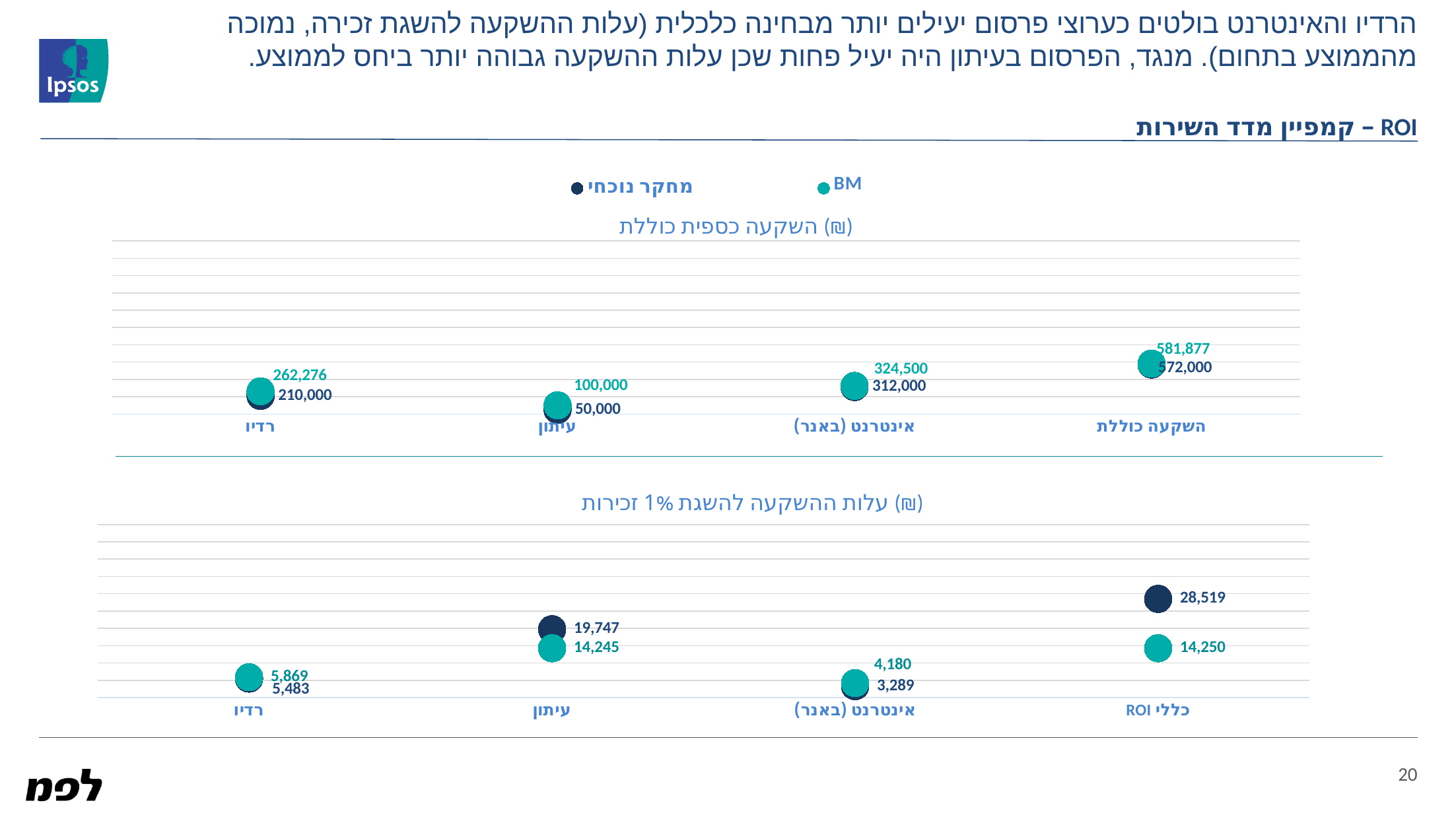
In the bottom chart (עלות ההשקעה להשגת 1% זכירות), which category has the lowest מחקר נוכחי value? אינטרנט (באנר) In the top chart (השקעה כספית כוללת), what is the מחקר נוכחי value for רדיו? 210,000 In the top chart (השקעה כספית כוללת), what is the difference between the BM and מחקר נוכחי values for עיתון? 50,000 How many series does the legend list? 2 In the bottom chart (עלות ההשקעה להשגת 1% זכירות), which is larger for אינטרנט (באנר): the BM value or the מחקר נוכחי value? BM In the top chart (השקעה כספית כוללת), which category has the lowest מחקר נוכחי value? עיתון In the bottom chart (עלות ההשקעה להשגת 1% זכירות), what is the difference between the מחקר נוכחי and BM values for ROI כללי? 14,269 In the top chart (השקעה כספית כוללת), what is the BM value for השקעה כוללת? 581,877 In the bottom chart (עלות ההשקעה להשגת 1% זכירות), what is the BM value for עיתון? 14,245 In the bottom chart (עלות ההשקעה להשגת 1% זכירות), what is the מחקר נוכחי value for ROI כללי? 28,519 In the top chart (השקעה כספית כוללת), what is the BM value for אינטרנט (באנר)? 324,500 How many categories are shown on the x axis of the top chart (השקעה כספית כוללת)? 4